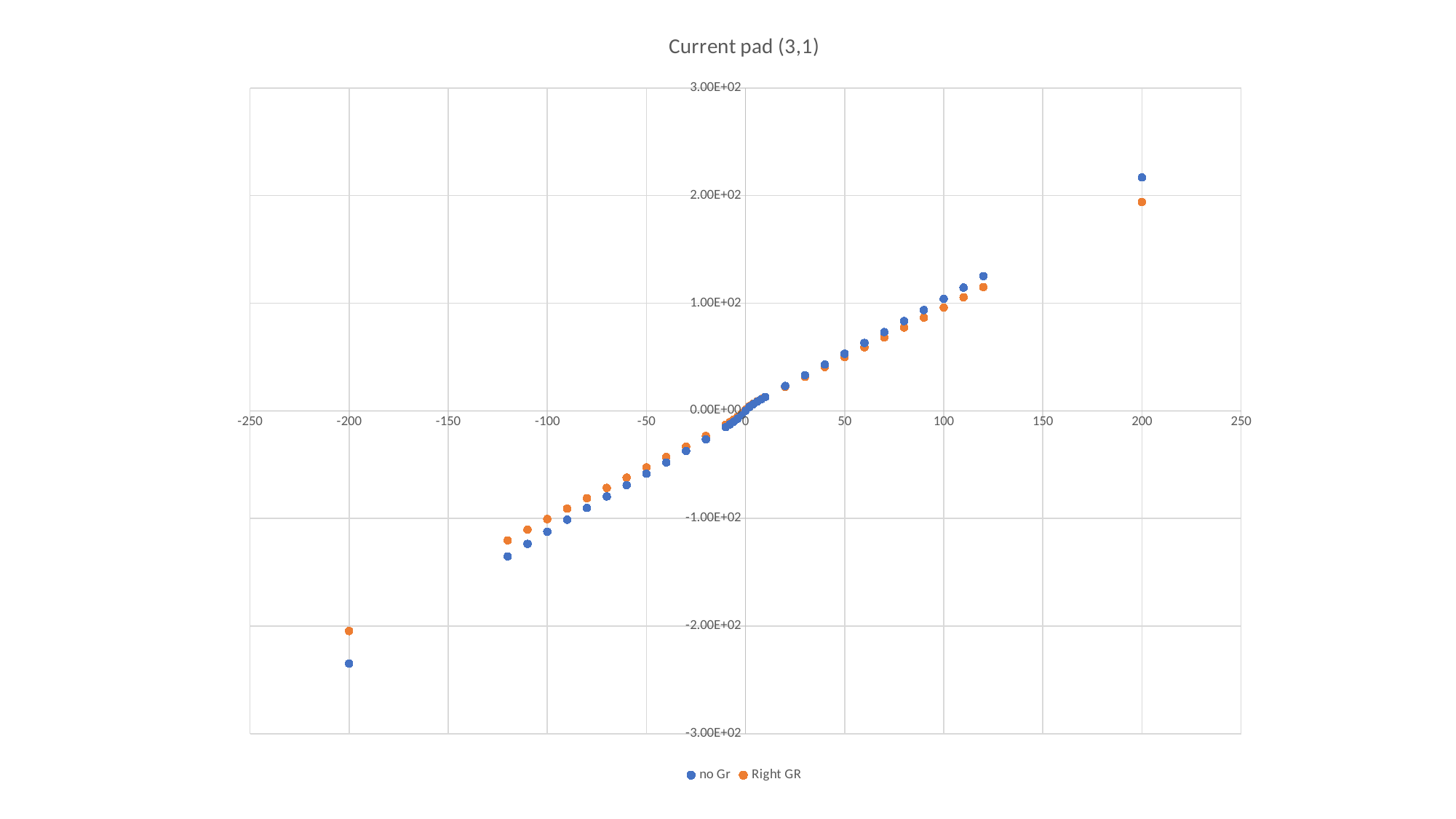
What kind of chart is shown on the slide? scatter chart At x = -200, which series has the lower value, no Gr or Right GR? no Gr Is the value for the no Gr series at x = -200 greater or less than -2.00E+02? less What is the title of the chart? Current pad (3,1) Do the plotted values rise or fall as the x value increases? rise Is the value for the no Gr series at x = 200 greater or less than 2.00E+02? greater Is the value for the Right GR series at x = 200 greater or less than 2.00E+02? less What are the names of the two series in the legend? no Gr and Right GR At x = 200, which series has the higher value, no Gr or Right GR? no Gr How many series does the legend list? 2 At x = 120, which series has the higher value, no Gr or Right GR? no Gr